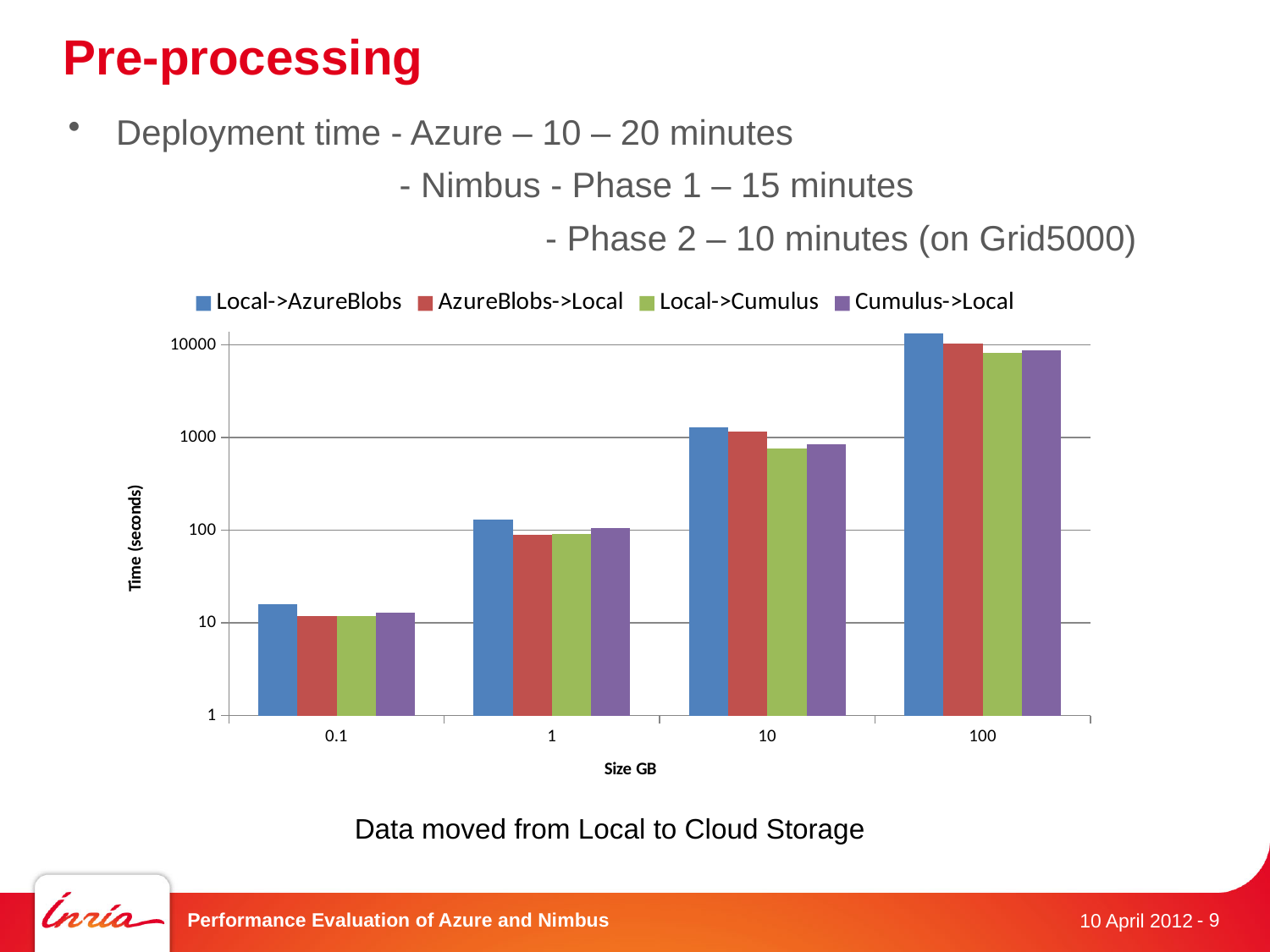
At 100 GB, which series has the highest time? Local->AzureBlobs Is the value for Local->AzureBlobs at 0.1 GB greater or less than 10 seconds? greater Is the value for Local->AzureBlobs at 100 GB greater or less than 10000 seconds? greater What kind of chart is shown on the slide? bar chart Does the time for Local->AzureBlobs rise or fall as the size in GB increases? rise What is the label of the y axis of the chart? Time (seconds) How many series does the chart legend list? 4 Is the value for Local->AzureBlobs at 1 GB greater or less than 100 seconds? greater What is the label of the x axis of the chart? Size GB At 10 GB, which is larger: Local->AzureBlobs or Local->Cumulus? Local->AzureBlobs How many size categories are shown on the x axis of the chart? 4